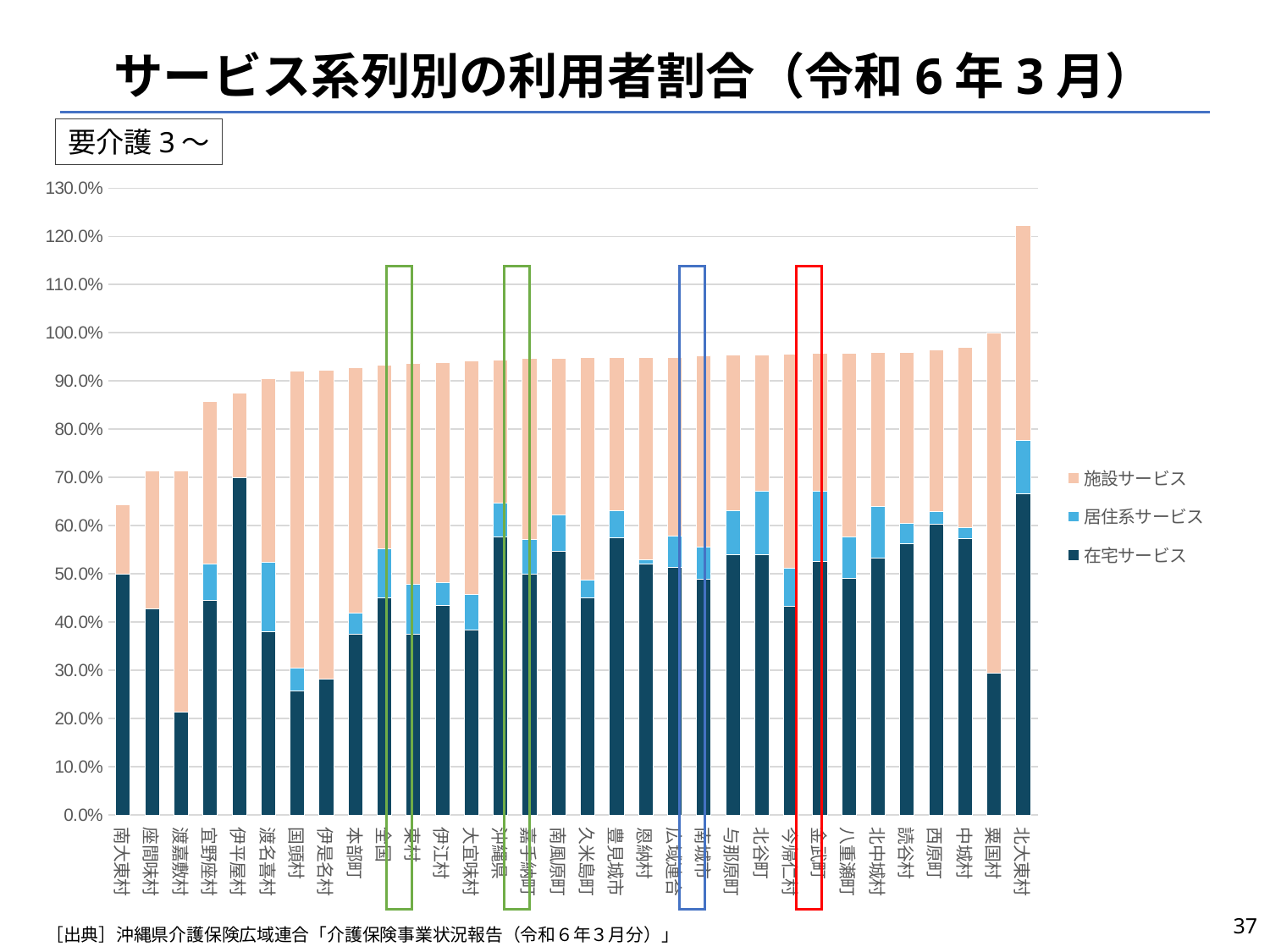
How many categories are plotted along the x axis? 32 How many series does the legend list? 3 Is the 在宅サービス value for 伊平屋村 greater or less than 60.0%? greater Is the total stacked value for 北大東村 greater or less than 110.0%? greater Which category has the lowest total stacked bar? 南大東村 Which category has the highest total stacked bar? 北大東村 Which legend entry is shown in the darkest colour? 在宅サービス What kind of chart is shown on the slide? stacked bar chart Is the 在宅サービス value for 渡嘉敷村 greater or less than 30.0%? less Which has the larger 在宅サービス value, 伊平屋村 or 渡嘉敷村? 伊平屋村 Which category has the lowest 在宅サービス value? 渡嘉敷村 Do the total stacked bar heights generally rise or fall from left to right along the x axis? rise